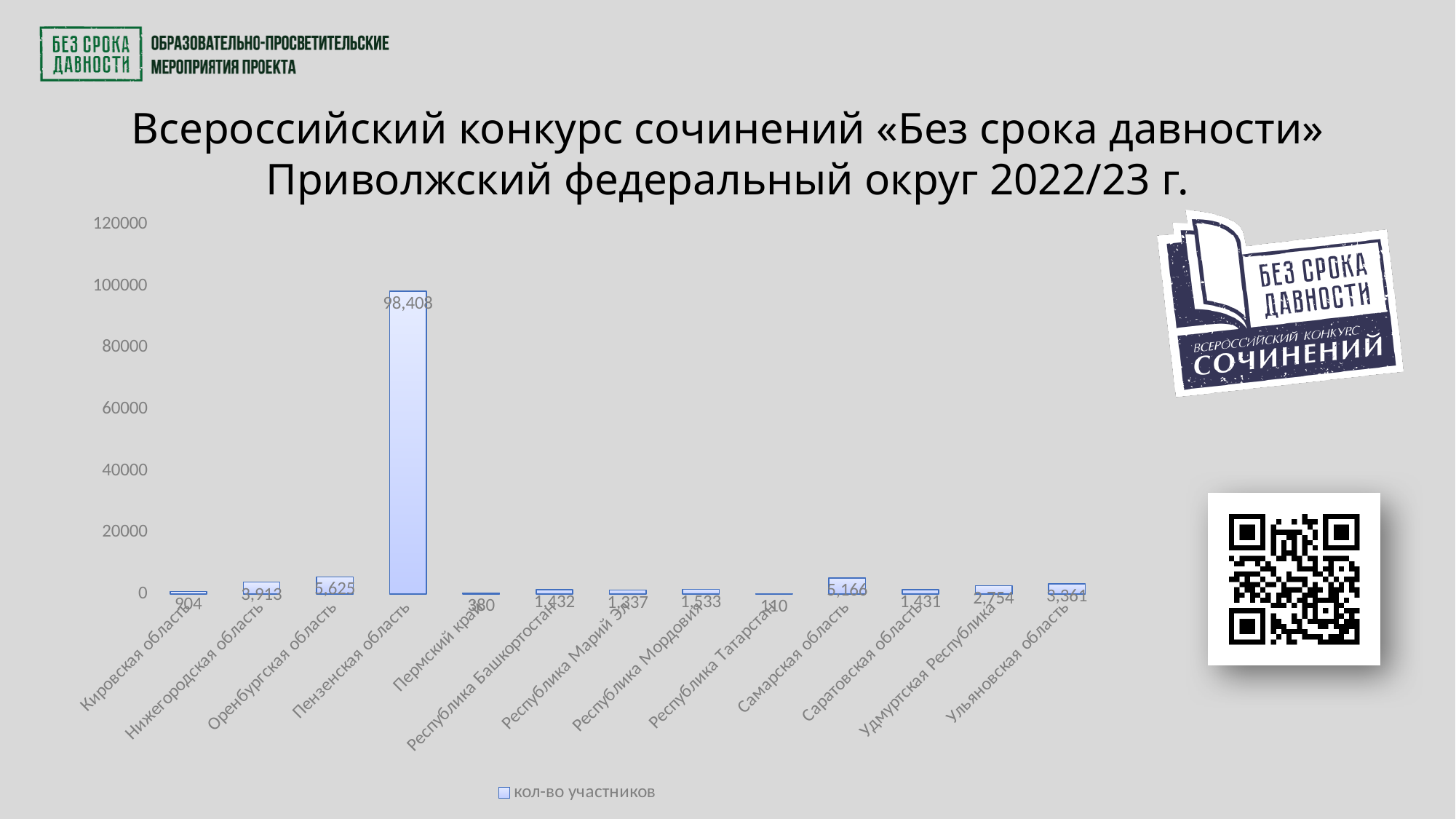
What is the value for Оренбургская область? 5,625 How many regions are shown on the x axis? 13 Which region has the highest value? Пензенская область What is the value for Самарская область? 5,166 What is the value for Пензенская область? 98,408 Which is larger, the value for Нижегородская область or the value for Удмуртская Республика? Нижегородская область What kind of chart is shown on the slide? bar chart How many series does the legend list? 1 What is the difference between the values for Оренбургская область and Самарская область? 459 What is the difference between the values for Нижегородская область and Ульяновская область? 552 Is the value for Пензенская область greater or less than 80000? greater What is the value for Удмуртская Республика? 2,754